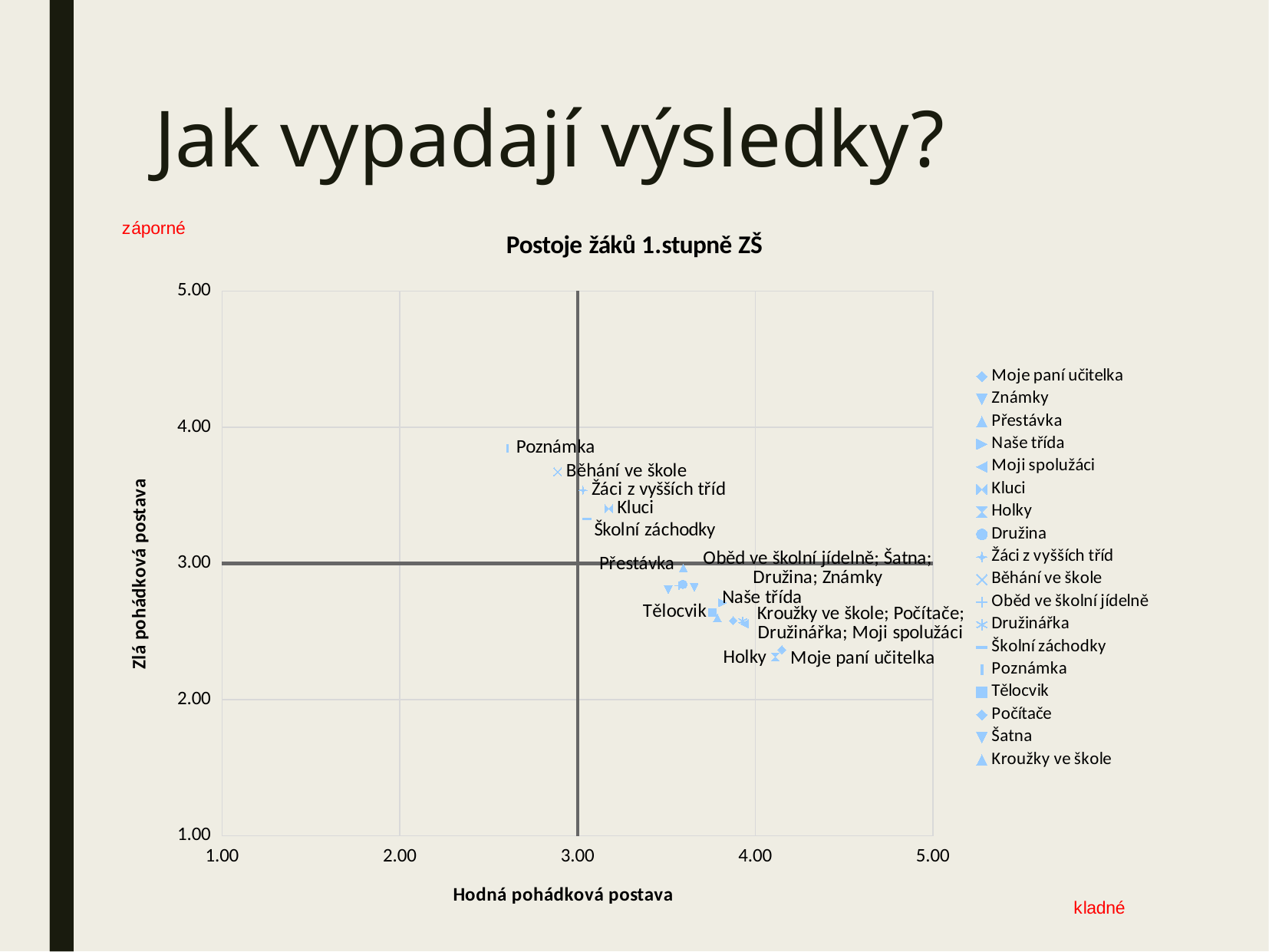
Is the vertical-axis value (Zlá pohádková postava) for Poznámka greater or less than 3.00? greater What kind of chart is shown on the slide? scatter chart Is the vertical-axis value for Běhání ve škole greater or less than 3.00? greater Which point has the highest value on the vertical axis (Zlá pohádková postava)? Poznámka Is the horizontal-axis value (Hodná pohádková postava) for Poznámka greater or less than 3.00? less Which has the higher vertical-axis value, Poznámka or Holky? Poznámka What is the title of the chart? Postoje žáků 1.stupně ZŠ How many series does the chart's legend list? 18 What is the label of the horizontal axis of the chart? Hodná pohádková postava